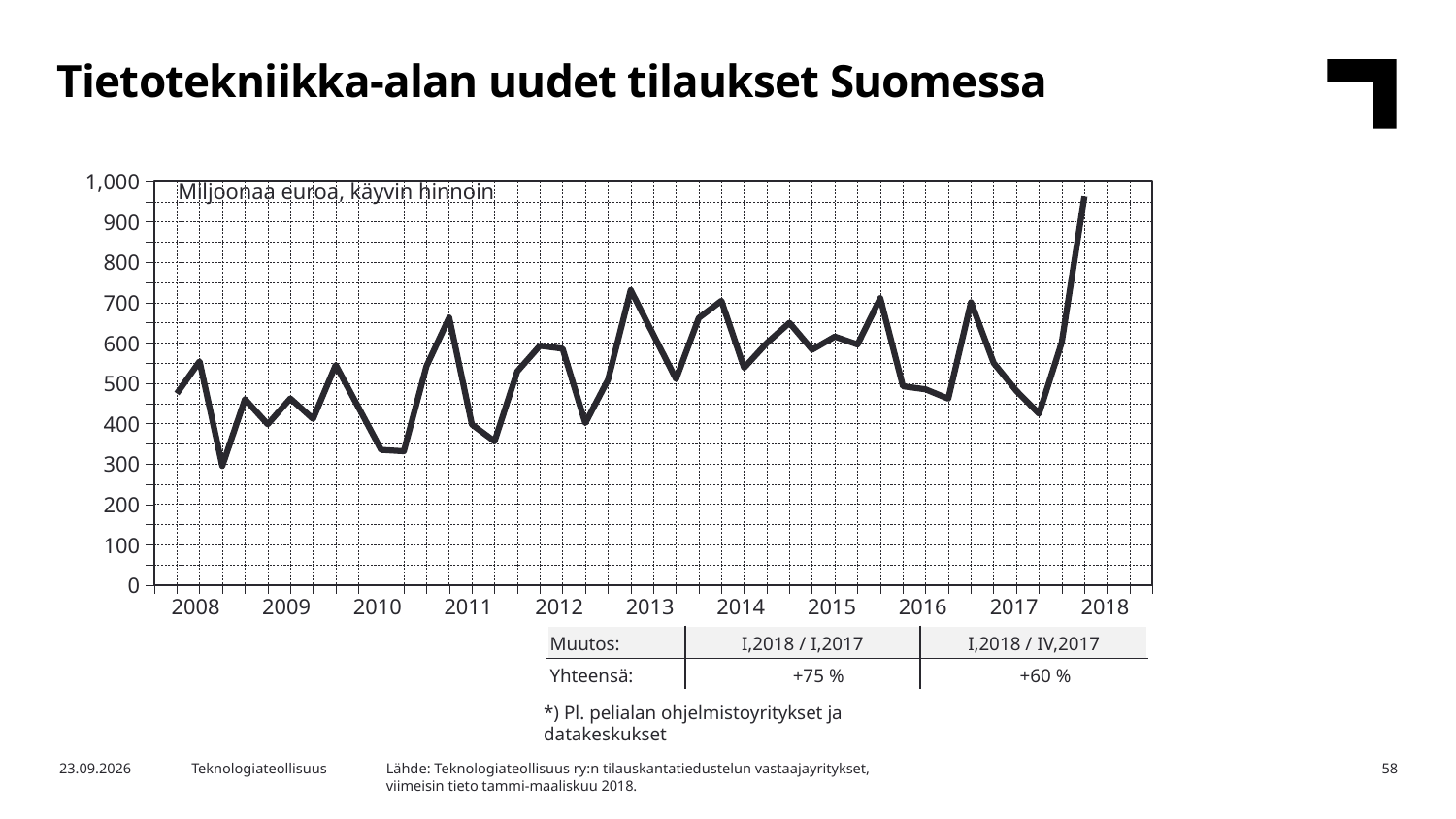
What is the title of the slide's chart? Tietotekniikka-alan uudet tilaukset Suomessa In which year does the line reach its lowest point? 2008 Does the line rise or fall from the end of 2017 to the last point in 2018? rise Is the value at the final point of the line (2018) greater or less than 900? greater Is the peak of the line in 2013 greater or less than 700? greater What type of chart is shown on the slide? line chart Is the lowest point of the line in 2010 greater or less than 400? less According to the table below the chart, what is the change (Muutos) for I,2018 / I,2017? +75 % In which year does the line reach its highest point? 2018 Which is higher: the peak of the line in 2018 or the peak in 2013? 2018 What unit label is printed inside the chart area? Miljoonaa euroa, käyvin hinnoin